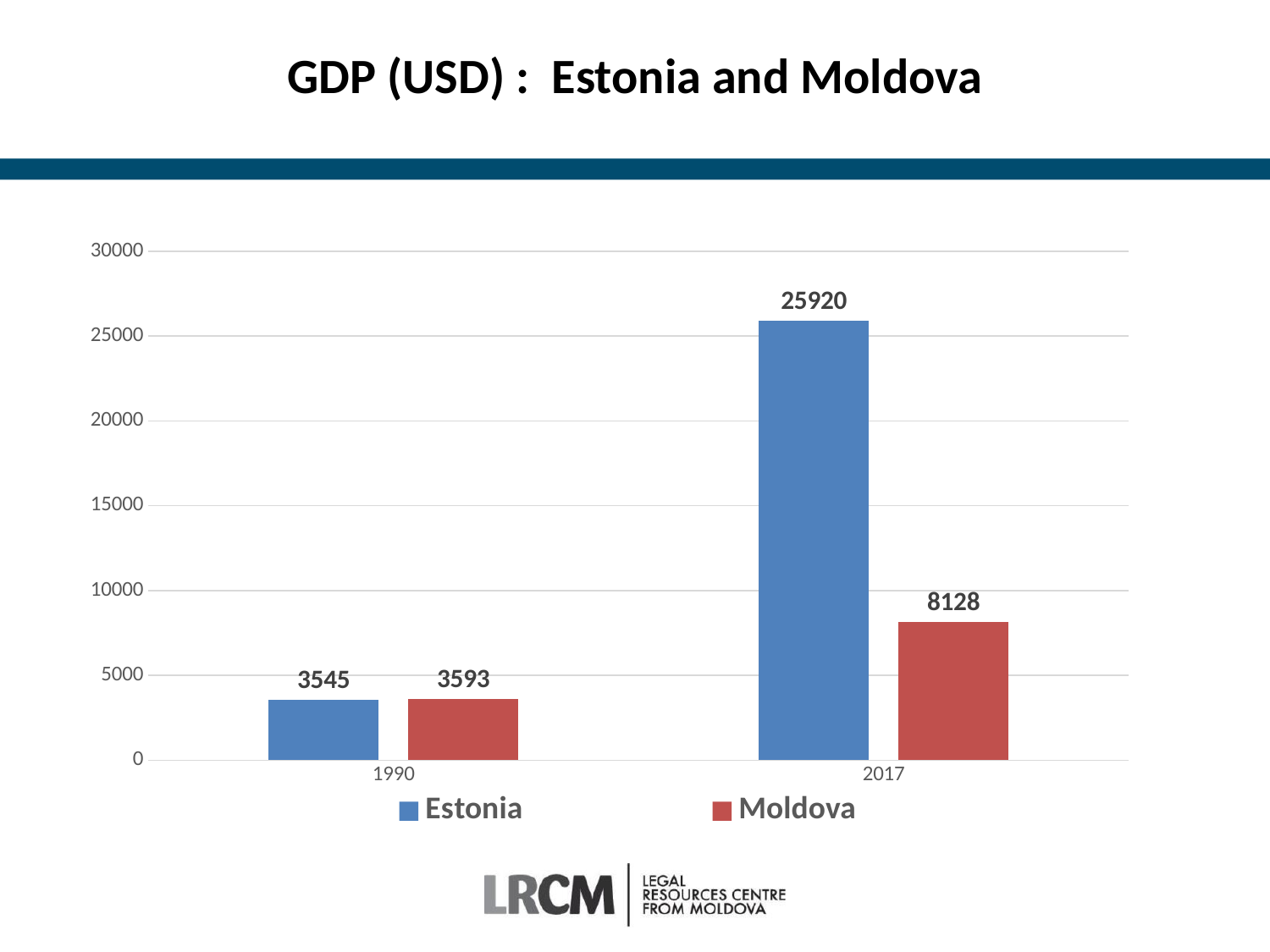
How many series does the legend list? 2 What is the difference between Estonia's and Moldova's GDP in 2017? 17792 Which bar has the highest value on the chart? Estonia in 2017 What is the GDP value for Estonia in 1990? 3545 What is the title of the chart? GDP (USD) : Estonia and Moldova Is the value for Moldova in 2017 greater or less than 10000? less What kind of chart is shown on the slide? Bar chart What is the GDP value for Moldova in 1990? 3593 Which is larger in 2017, Estonia's GDP or Moldova's GDP? Estonia What is the GDP value for Estonia in 2017? 25920 What is the GDP value for Moldova in 2017? 8128 What is the difference between Moldova's and Estonia's GDP in 1990? 48